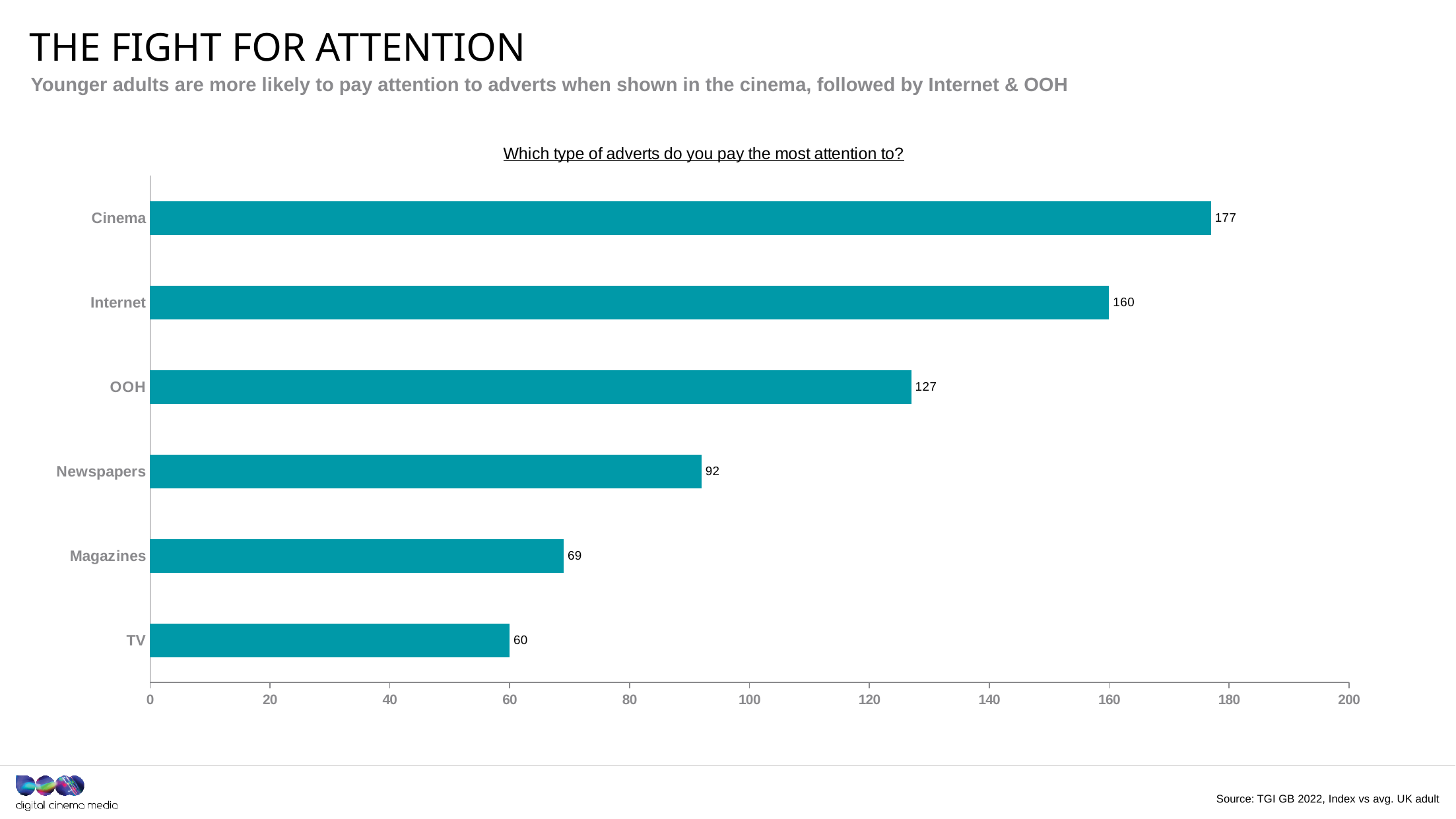
Which category has the highest value? Cinema What is the value for Magazines? 69 How many categories are shown in the chart? 6 Is the value for Internet greater or less than 140? greater What is the difference between the values for Newspapers and TV? 32 Which category has the lowest value? TV What kind of chart is shown on the slide? Bar chart What is the difference between the values for Cinema and Internet? 17 What is the value for OOH? 127 What is the value for Cinema? 177 Which is larger, the value for OOH or the value for Newspapers? OOH What is the title of the chart? Which type of adverts do you pay the most attention to?